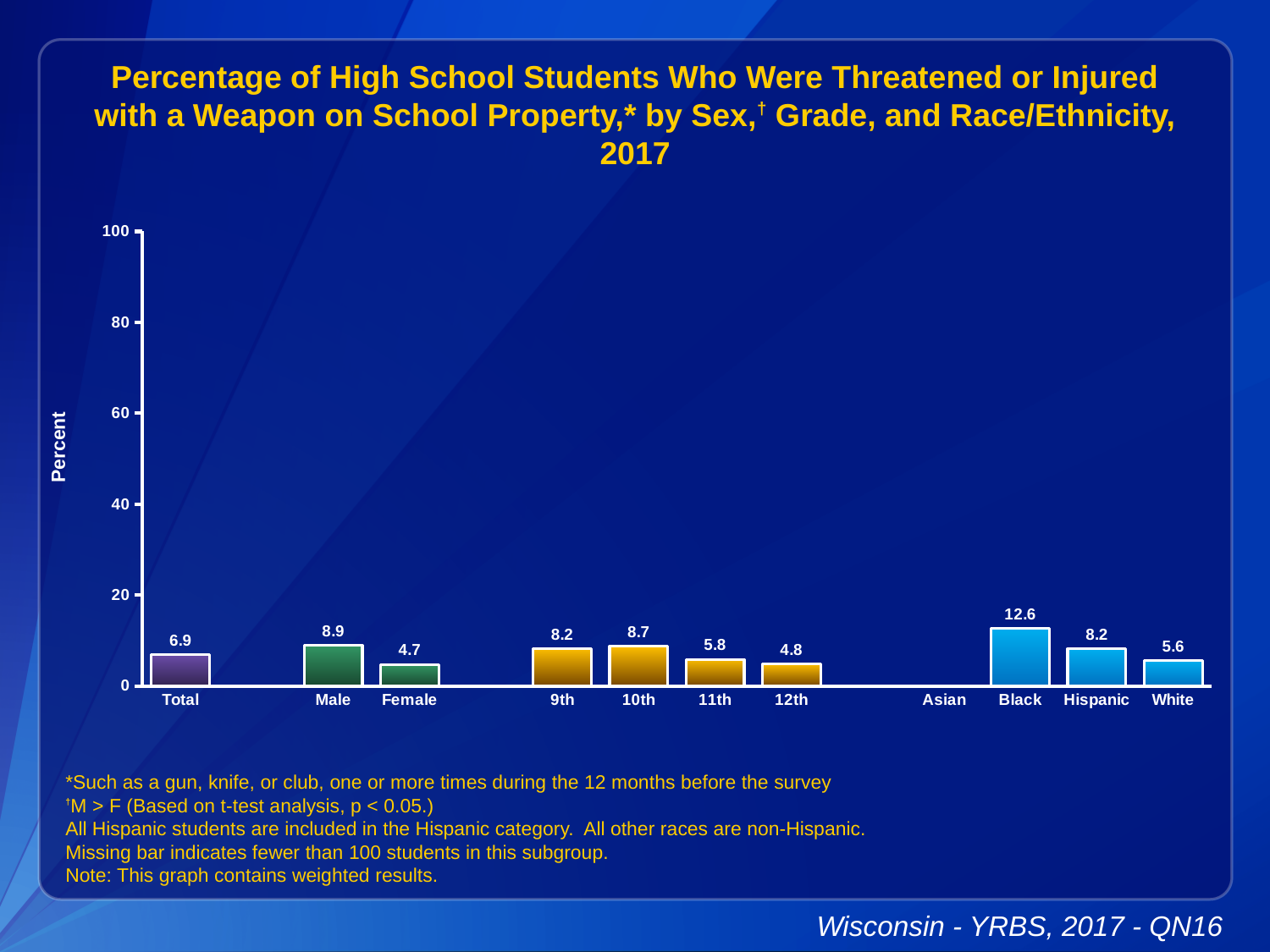
What is the value for Black students? 12.6 What is the value for Male? 8.9 Which category has the highest value? Black What is the difference between the Male and Female values? 4.2 What is the value for Total? 6.9 What kind of chart is this? bar chart Is the value for Black students greater or less than 20? less Which category on the x axis has no bar shown? Asian How many categories have a bar plotted? 11 What is the value for 10th grade? 8.7 Which is larger, the value for 9th grade or 12th grade? 9th Which category has the lowest plotted value? Female